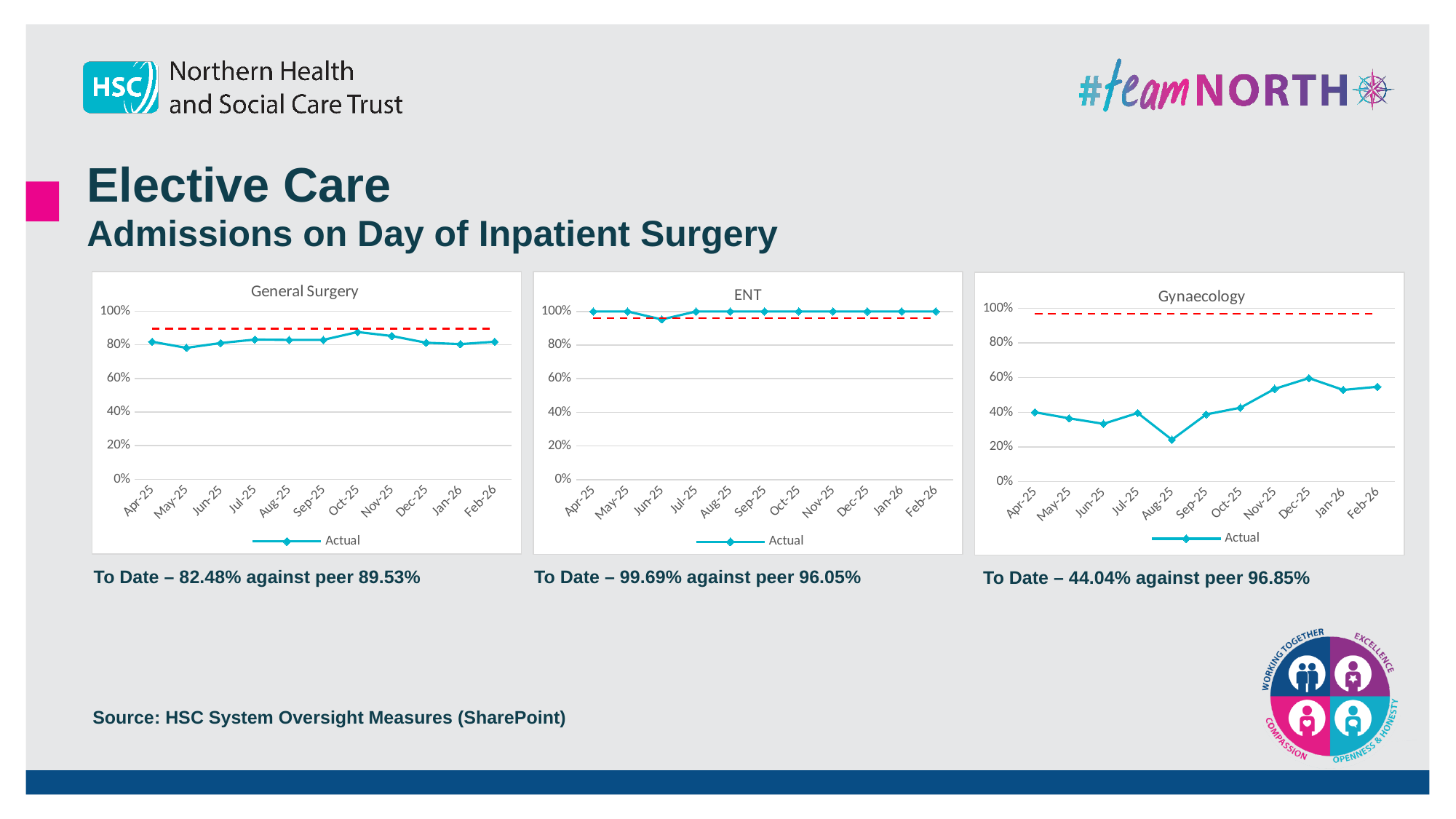
On the General Surgery chart, is the Actual value for Oct-25 greater or less than 80%? greater On the ENT chart, which month has the lowest Actual value? Jun-25 How many monthly data points are plotted on the ENT chart? 11 On the Gynaecology chart, do the Actual values rise or fall from Aug-25 to Dec-25? rise What kind of chart is the General Surgery chart? line chart How many series does the legend of the Gynaecology chart list? 1 On the ENT chart, is the Actual value for Jun-25 greater or less than 80%? greater On the Gynaecology chart, which month has the highest Actual value? Dec-25 On the Gynaecology chart, which month has the lowest Actual value? Aug-25 On the General Surgery chart, which month has the highest Actual value? Oct-25 On the Gynaecology chart, which is larger, the Actual value for Dec-25 or for Apr-25? Dec-25 On the Gynaecology chart, is the Actual value for Aug-25 greater or less than 40%? less